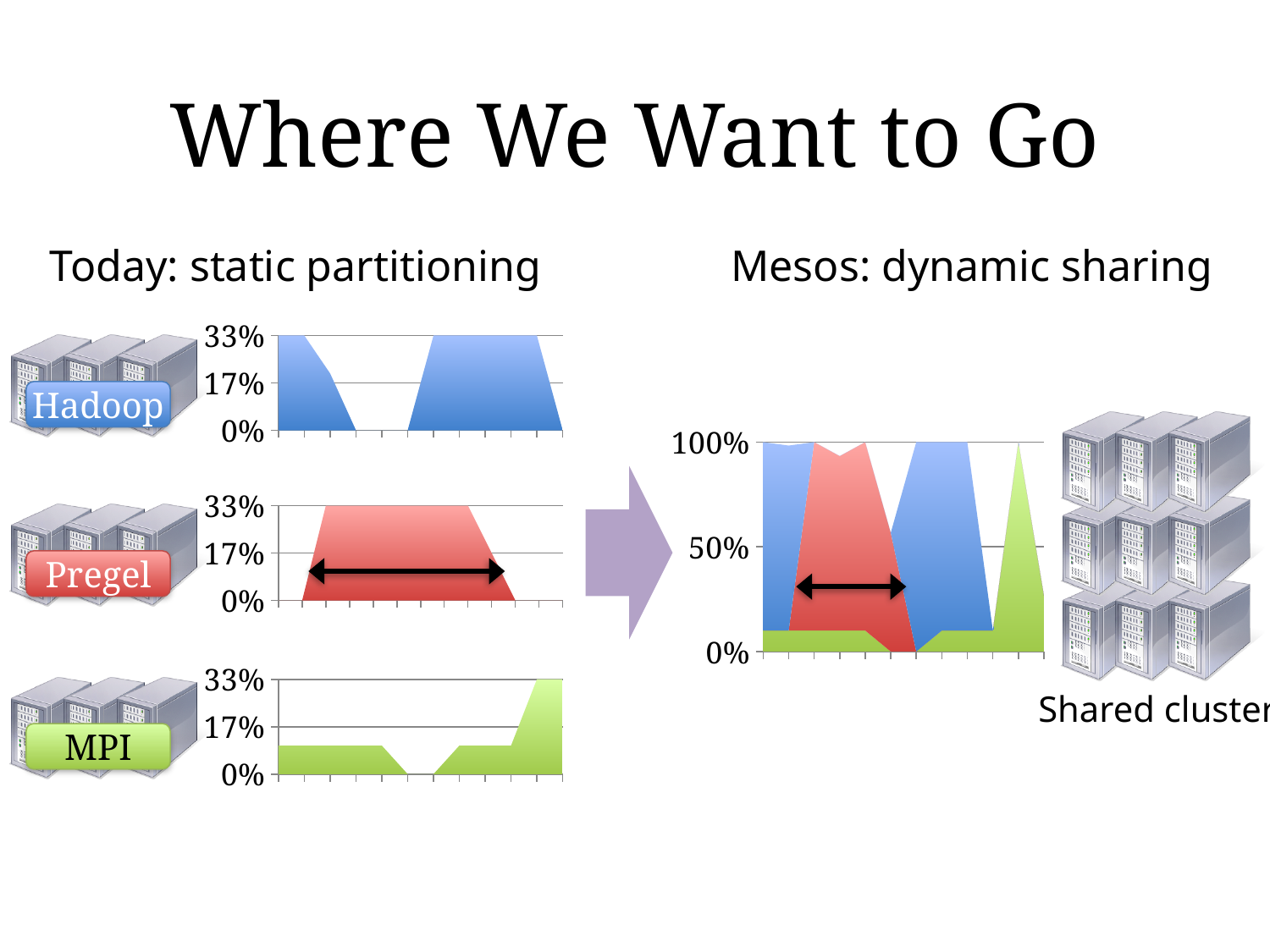
In the MPI chart, is the value at the far right end greater or less than 17%? greater In the "Mesos: dynamic sharing" chart, is the green area's value at the far left end greater or less than 50%? less How many charts are shown under the heading "Today: static partitioning"? 3 In the Hadoop chart, is the value at the far left end greater or less than 17%? greater In the "Mesos: dynamic sharing" chart, how many differently coloured areas are plotted? 3 What colour is the plotted area in the Pregel chart? red What kind of chart is the Hadoop chart under "Today: static partitioning"? area chart What is the highest value labelled on the y axis of the "Mesos: dynamic sharing" chart? 100%